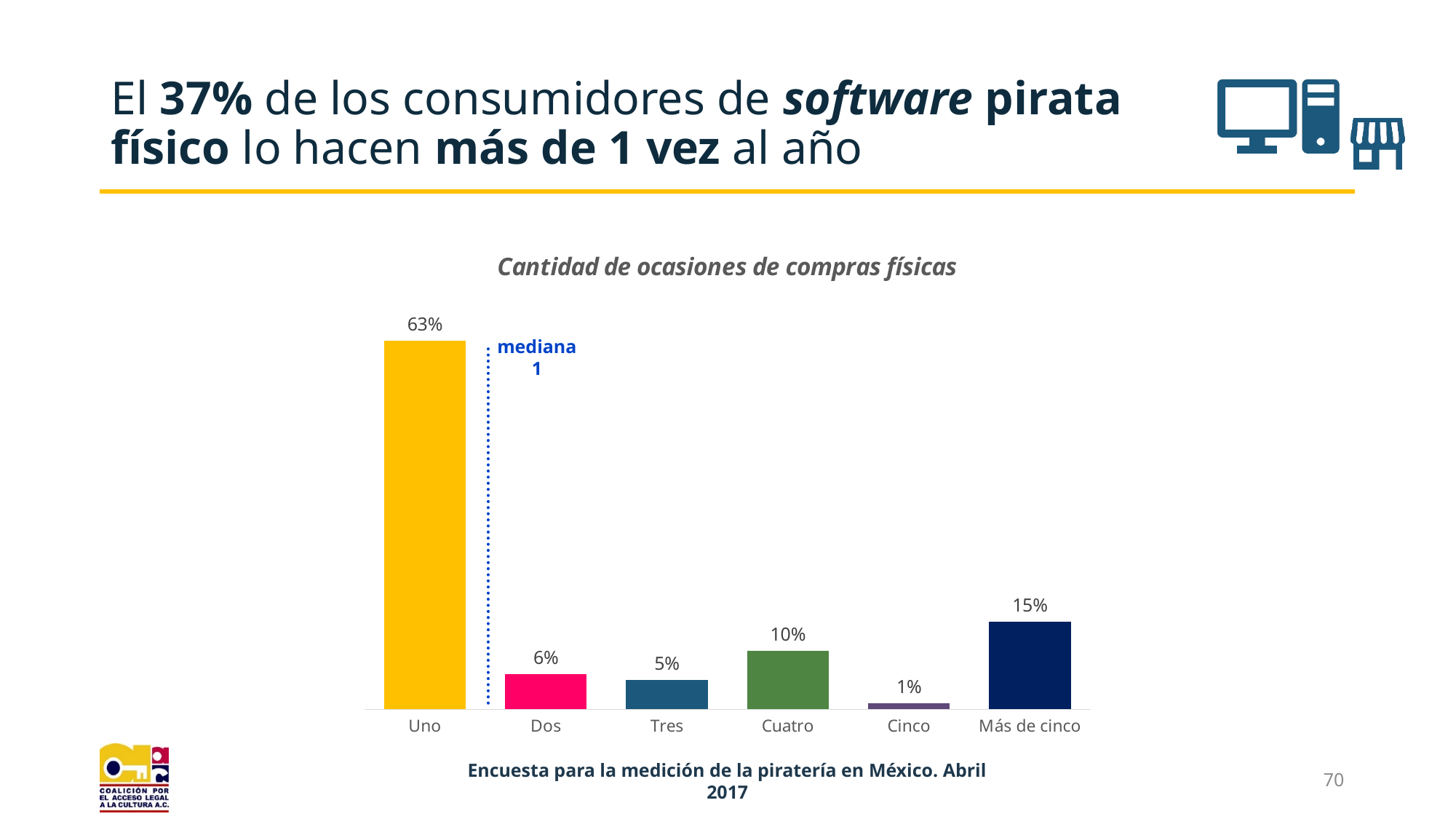
Which is larger, the value for 'Cuatro' or the value for 'Dos'? Cuatro Which category has the lowest value? Cinco What kind of chart is shown on the slide? Bar chart What is the difference between the values for 'Dos' and 'Tres'? 1% What is the title of the chart? Cantidad de ocasiones de compras físicas Which category has the highest value? Uno How many categories are shown on the x axis? 6 What is the value for the 'Cuatro' category? 10% What is the value for the 'Uno' category? 63% What is the value for the 'Cinco' category? 1% What is the difference between the values for 'Uno' and 'Más de cinco'? 48% What is the value for the 'Más de cinco' category? 15%